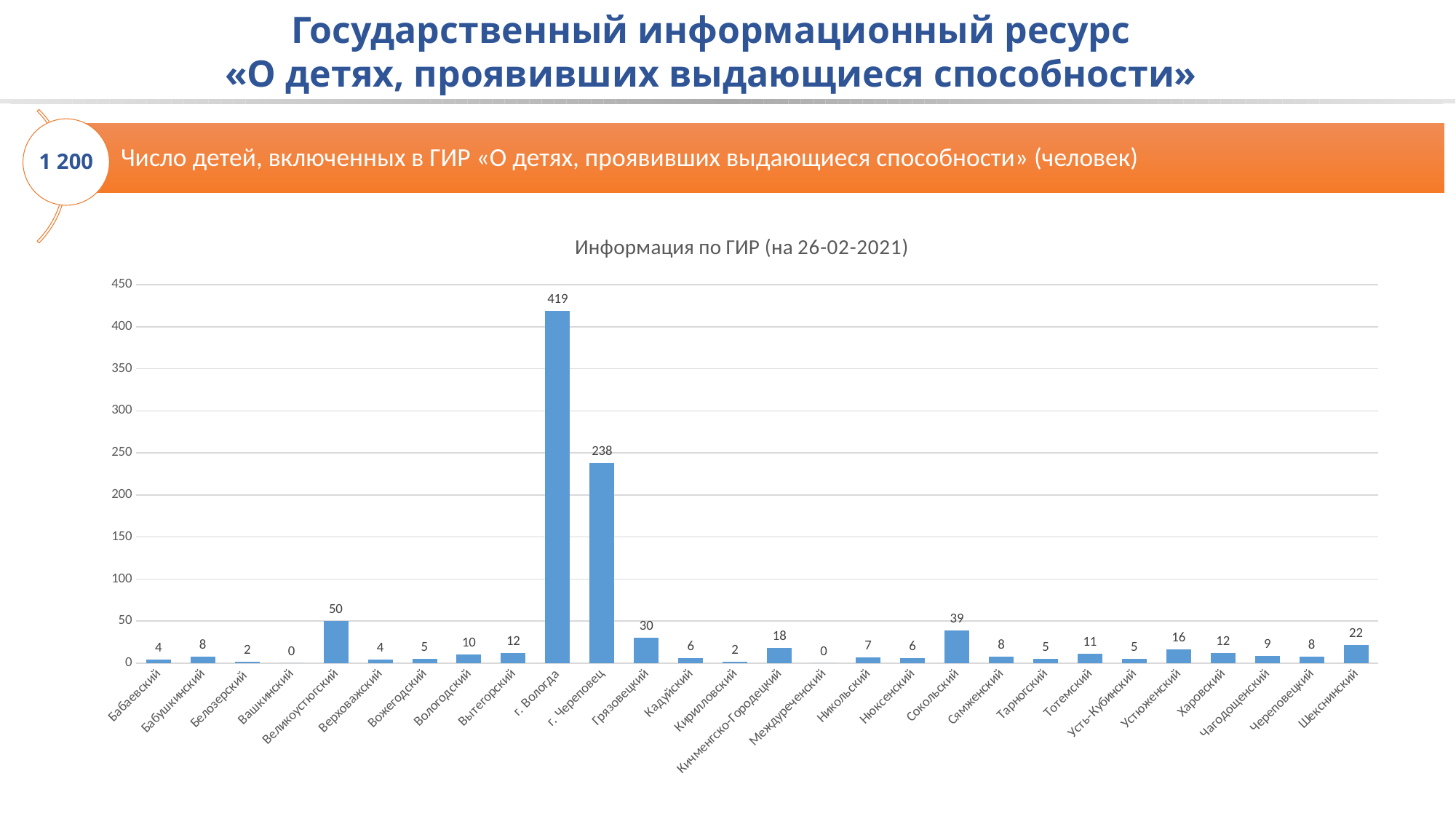
What is the value for Шекснинский? 22 What is the value for г. Вологда? 419 How many categories are shown on the x axis? 28 What is the value for г. Череповец? 238 What is the difference between the values for Великоустюгский and Сокольский? 11 What kind of chart is shown on the slide? bar chart What is the value for Великоустюгский? 50 What is the value for Сокольский? 39 What is the difference between the values for г. Вологда and г. Череповец? 181 Is the value for г. Череповец greater or less than 200? greater Which is larger, the value for Грязовецкий or the value for Кичменгско-Городецкий? Грязовецкий Which category has the highest value? г. Вологда